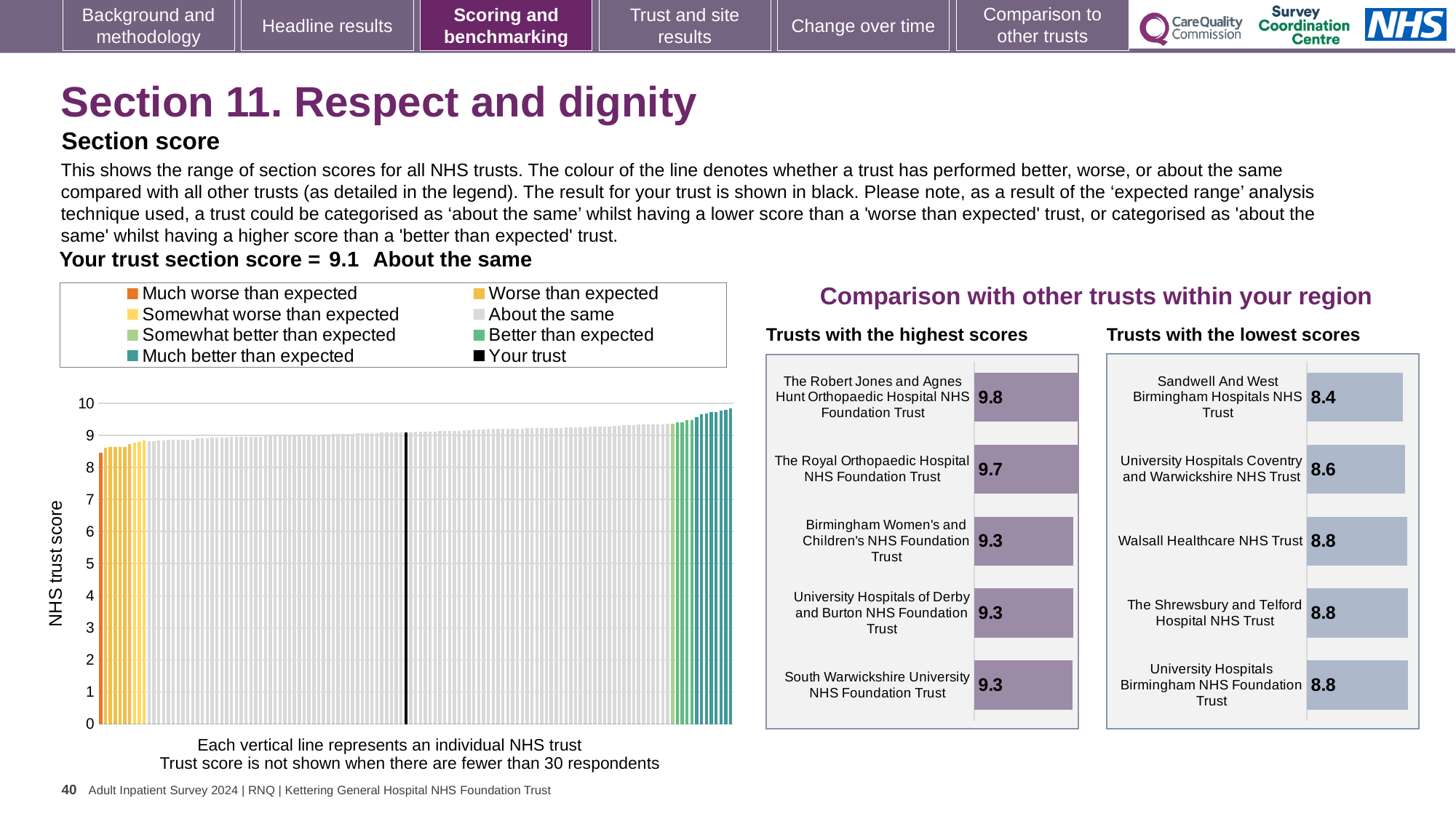
In the 'Trusts with the lowest scores' chart, which has the higher score: Walsall Healthcare NHS Trust or University Hospitals Coventry and Warwickshire NHS Trust? Walsall Healthcare NHS Trust What kind of chart is the large 'NHS trust score' chart on the left of the slide? Bar chart In the 'Trusts with the highest scores' chart, which trust has the highest score? The Robert Jones and Agnes Hunt Orthopaedic Hospital NHS Foundation Trust In the 'Trusts with the lowest scores' chart, what is the difference between the scores of University Hospitals Coventry and Warwickshire NHS Trust and Sandwell And West Birmingham Hospitals NHS Trust? 0.2 How many entries does the legend of the large 'NHS trust score' chart on the left list? 8 In the 'Trusts with the highest scores' chart, what is the difference between the scores of The Robert Jones and Agnes Hunt Orthopaedic Hospital NHS Foundation Trust and South Warwickshire University NHS Foundation Trust? 0.5 In the 'Trusts with the highest scores' chart, what is the score for The Robert Jones and Agnes Hunt Orthopaedic Hospital NHS Foundation Trust? 9.8 In the large 'NHS trust score' chart on the left, do the bars rise or fall from left to right? Rise In the 'Trusts with the lowest scores' chart, what is the score for Sandwell And West Birmingham Hospitals NHS Trust? 8.4 How many trusts are listed in the 'Trusts with the highest scores' chart? 5 In the 'Trusts with the lowest scores' chart, which trust has the lowest score? Sandwell And West Birmingham Hospitals NHS Trust In the 'Trusts with the highest scores' chart, what is the score for The Royal Orthopaedic Hospital NHS Foundation Trust? 9.7